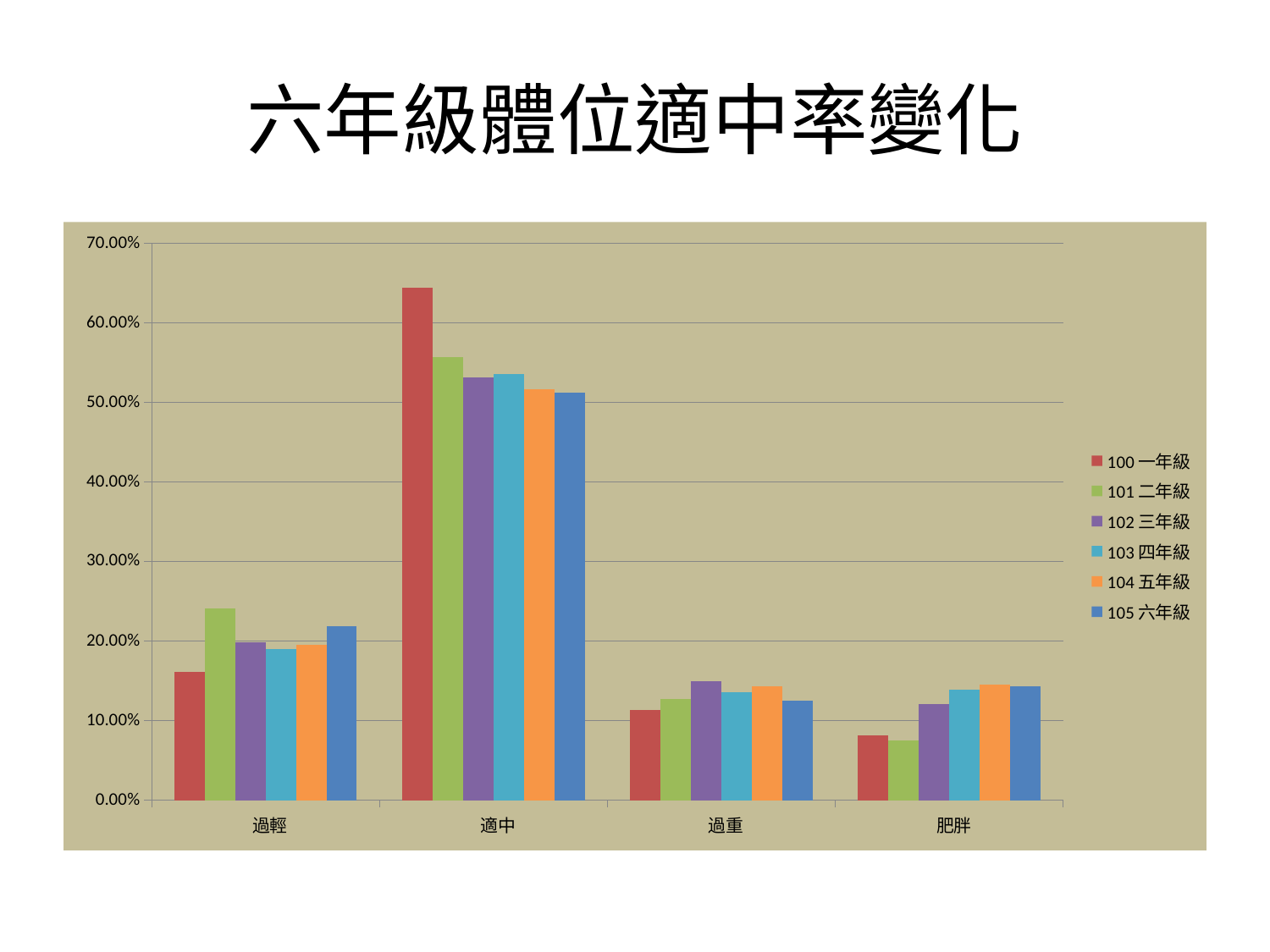
Is the 適中 value for 100 一年級 greater or less than 60.00%? greater In the 過輕 category, which series has the highest bar? 101 二年級 Across the series from 100 一年級 to 105 六年級, do the 適中 values generally rise or fall? fall In the 過輕 category, which is larger: 100 一年級 or 105 六年級? 105 六年級 What kind of chart is shown on the slide? bar chart Is the 肥胖 value for 100 一年級 greater or less than 10.00%? less What is the title of the slide? 六年級體位適中率變化 Is the 肥胖 value for 104 五年級 greater or less than 10.00%? greater How many categories are shown on the x axis? 4 How many series does the legend list? 6 In the 適中 category, which series has the highest bar? 100 一年級